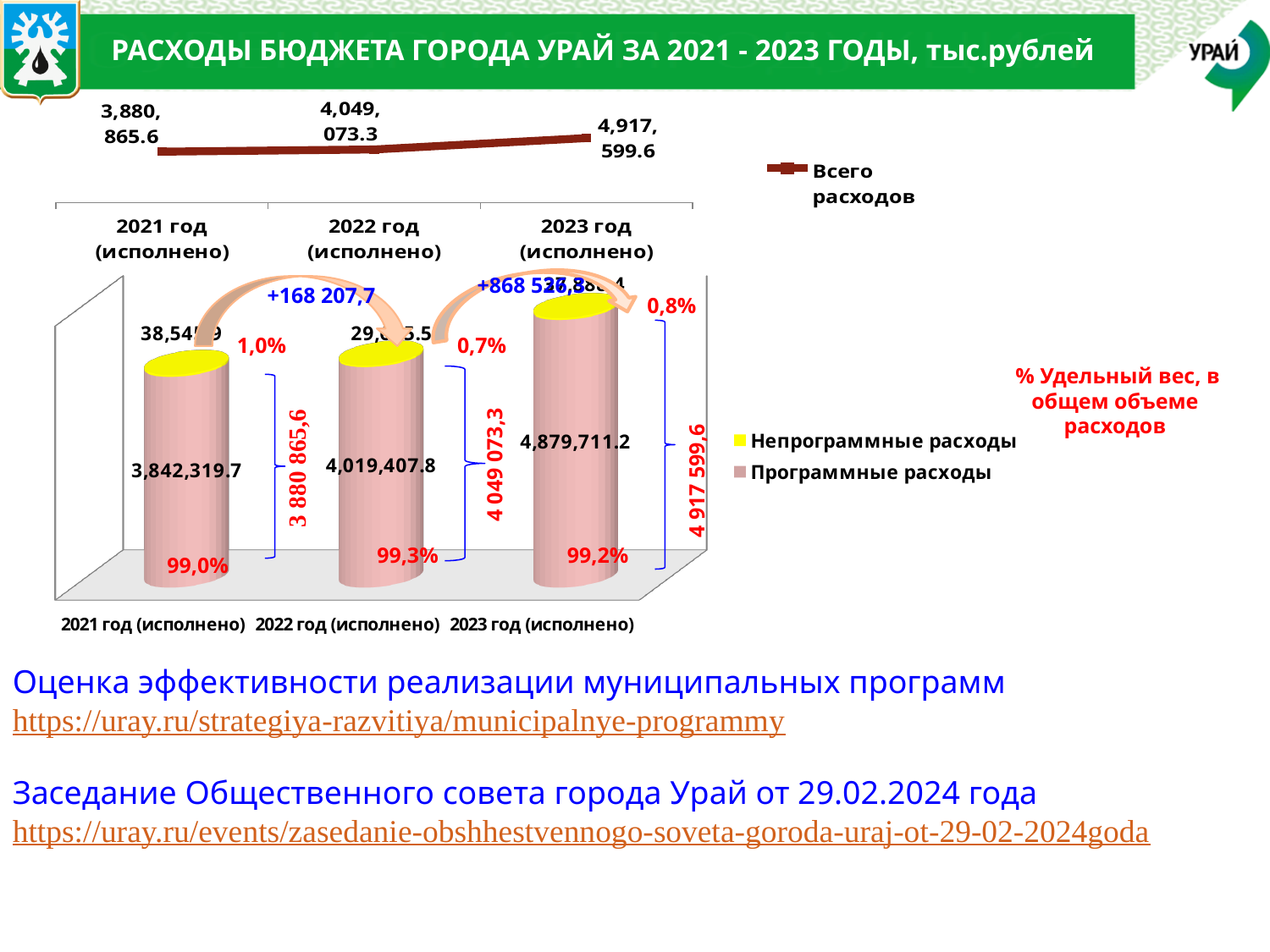
In the bottom bar chart, what is the value of Программные расходы for 2023 год (исполнено)? 4,879,711.2 In the bottom bar chart, what is the value of Программные расходы for 2021 год (исполнено)? 3,842,319.7 In the bottom bar chart, how many series does the legend list? 2 In the top line chart, do the values rise or fall from 2021 to 2023? rise In the top line chart, what is the value for 2022 год (исполнено)? 4,049,073.3 In the top line chart, what is the total expenditure (Всего расходов) for 2023 год (исполнено)? 4,917,599.6 In the bottom bar chart, which colour represents Непрограммные расходы? yellow In the top line chart, what is the total expenditure (Всего расходов) for 2021 год (исполнено)? 3,880,865.6 In the top line chart, which year has the highest total expenditure? 2023 год (исполнено) In the bottom bar chart, which year has the lowest Программные расходы? 2021 год (исполнено) In the top line chart, how many data points are plotted? 3 In the bottom bar chart, what is the value of Программные расходы for 2022 год (исполнено)? 4,019,407.8